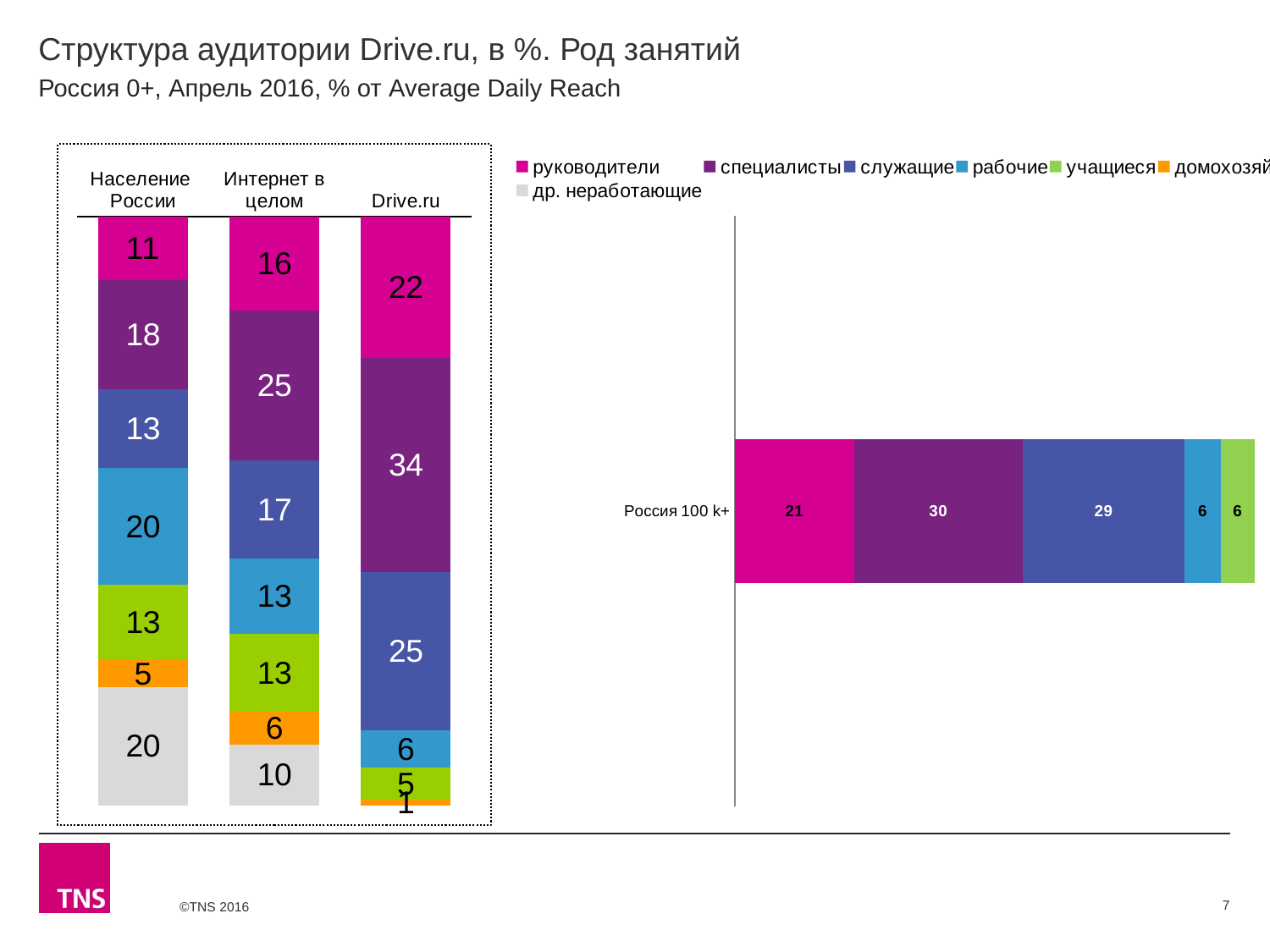
In the right chart, what is the value of the pink (руководители) segment for Россия 100 k+? 21 How many bars are shown in the left stacked bar chart? 3 In the left stacked bar chart, what is the value of the grey (др. неработающие) segment for Население России? 20 In the left stacked bar chart, what is the difference between the pink (руководители) values for Drive.ru and Население России? 11 How many series does the legend list? 7 In the right chart, which segment of the Россия 100 k+ bar is the largest? специалисты In the left stacked bar chart, what is the value of the purple (специалисты) segment for Интернет в целом? 25 What type of chart is shown on the right side of the slide? Stacked bar chart In the left stacked bar chart, which of the three bars has the largest purple (специалисты) segment? Drive.ru In the left stacked bar chart, which is larger: the light blue (рабочие) segment for Население России or for Drive.ru? Население России In the left stacked bar chart, what is the value of the pink (руководители) segment for Drive.ru? 22